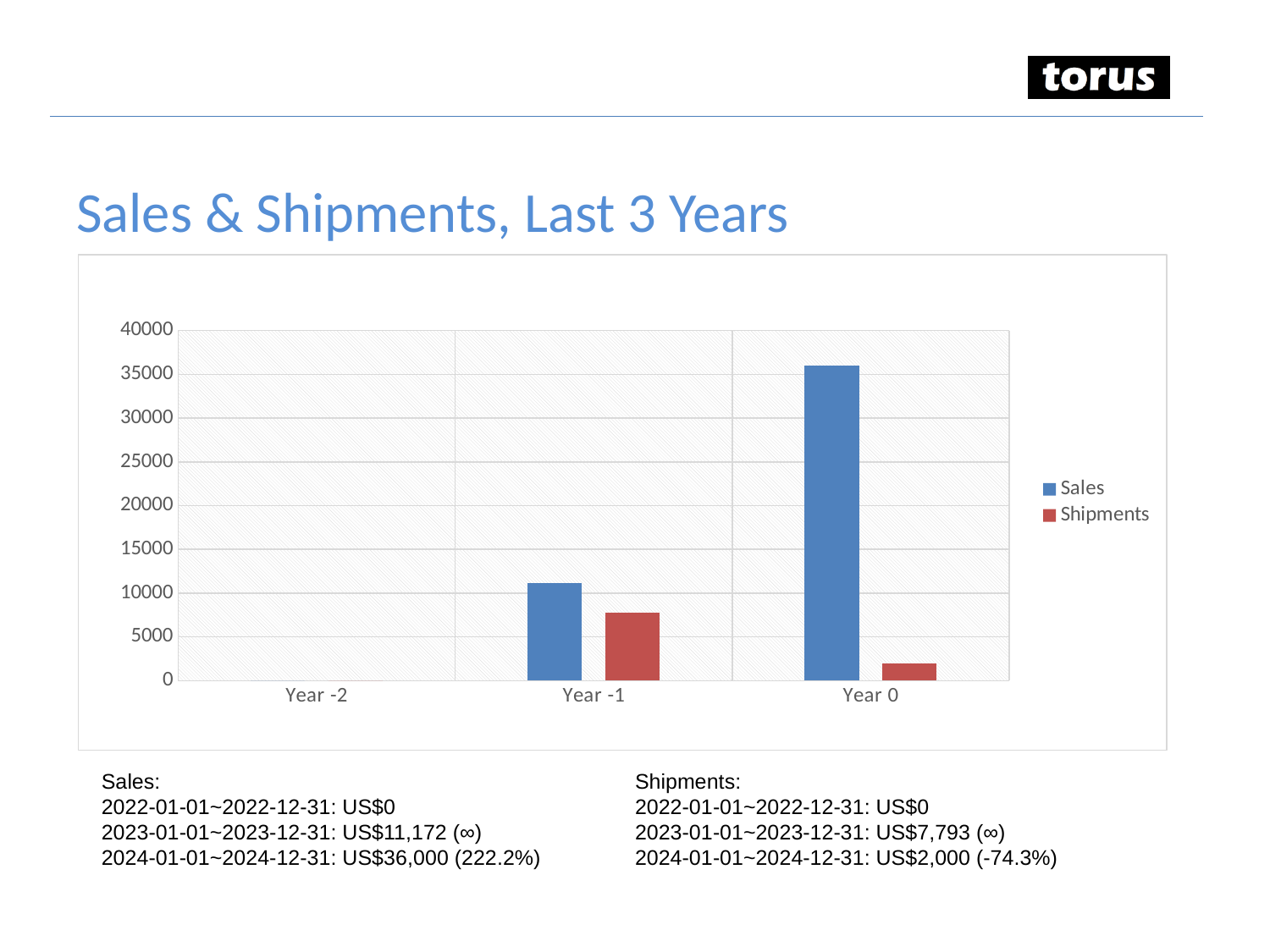
According to the text below the chart, what was Sales for 2024-01-01~2024-12-31? US$36,000 What is the title of the chart on the slide? Sales & Shipments, Last 3 Years Is the Sales value for Year 0 greater or less than 35000? greater What kind of chart is shown on the slide? bar chart Which category has the highest Shipments value? Year -1 Which category has the highest Sales value? Year 0 In Year -1, which is larger, Sales or Shipments? Sales According to the text below the chart, what was Shipments for 2023-01-01~2023-12-31? US$7,793 How many categories are shown on the x axis of the chart? 3 Do the Sales values rise or fall from Year -2 to Year 0? rise Is the Shipments value for Year -1 greater or less than 10000? less How many series does the chart legend list? 2